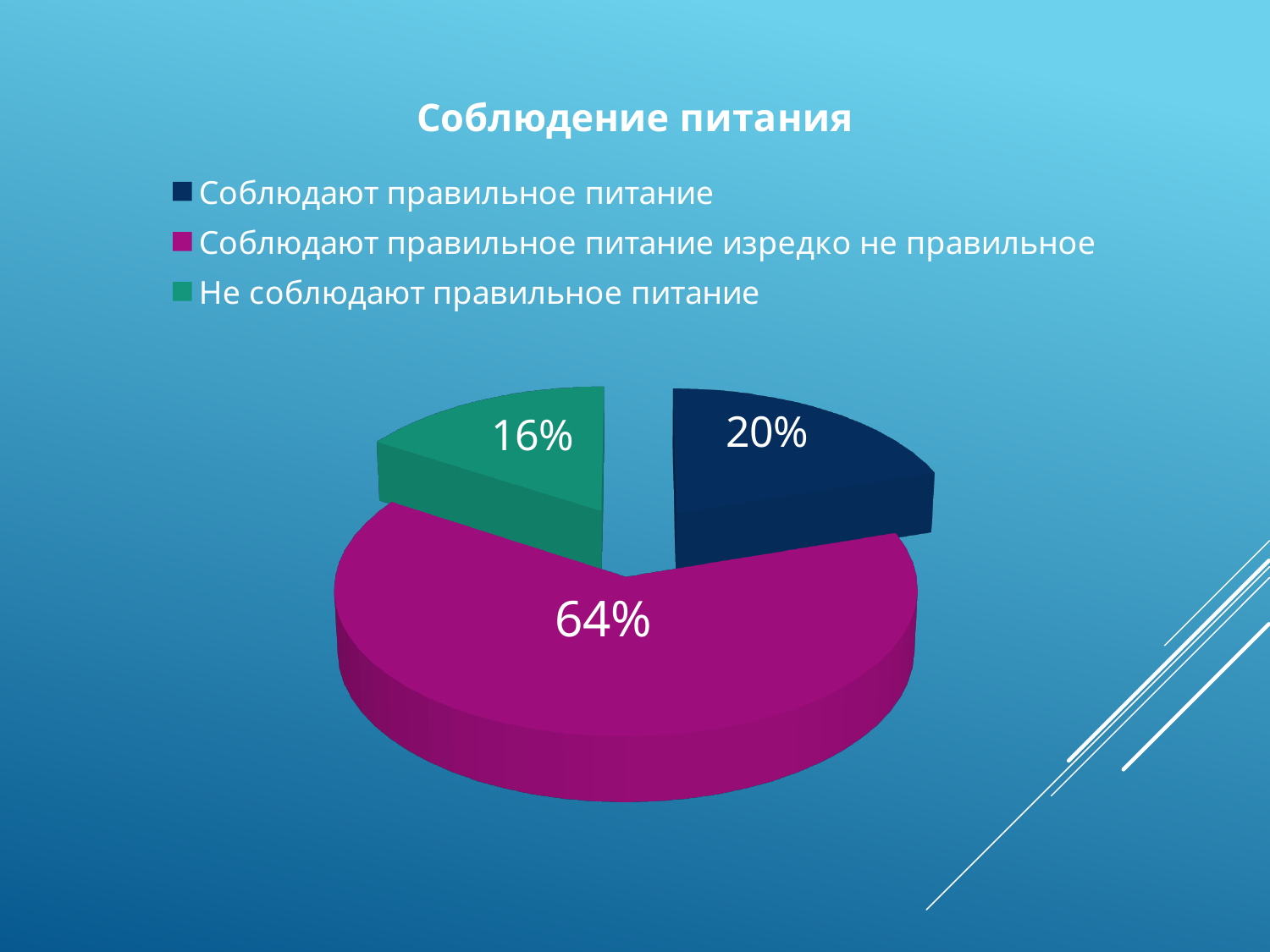
What kind of chart is shown on the slide? Pie chart Which category has the largest slice of the pie? Соблюдают правильное питание изредко не правильное What percentage of the pie is labelled for "Соблюдают правильное питание изредко не правильное"? 64% How many entries does the legend list? 3 What colour is the slice for "Не соблюдают правильное питание"? Green What is the difference in percentage points between the "Соблюдают правильное питание изредко не правильное" slice and the "Соблюдают правильное питание" slice? 44 How many slices does the pie chart have? 3 Which category has the smallest slice of the pie? Не соблюдают правильное питание What percentage of the pie is labelled for "Не соблюдают правильное питание"? 16% Which is larger: the slice for "Соблюдают правильное питание" or the slice for "Не соблюдают правильное питание"? Соблюдают правильное питание What is the title of the chart? Соблюдение питания What percentage of the pie is labelled for "Соблюдают правильное питание"? 20%